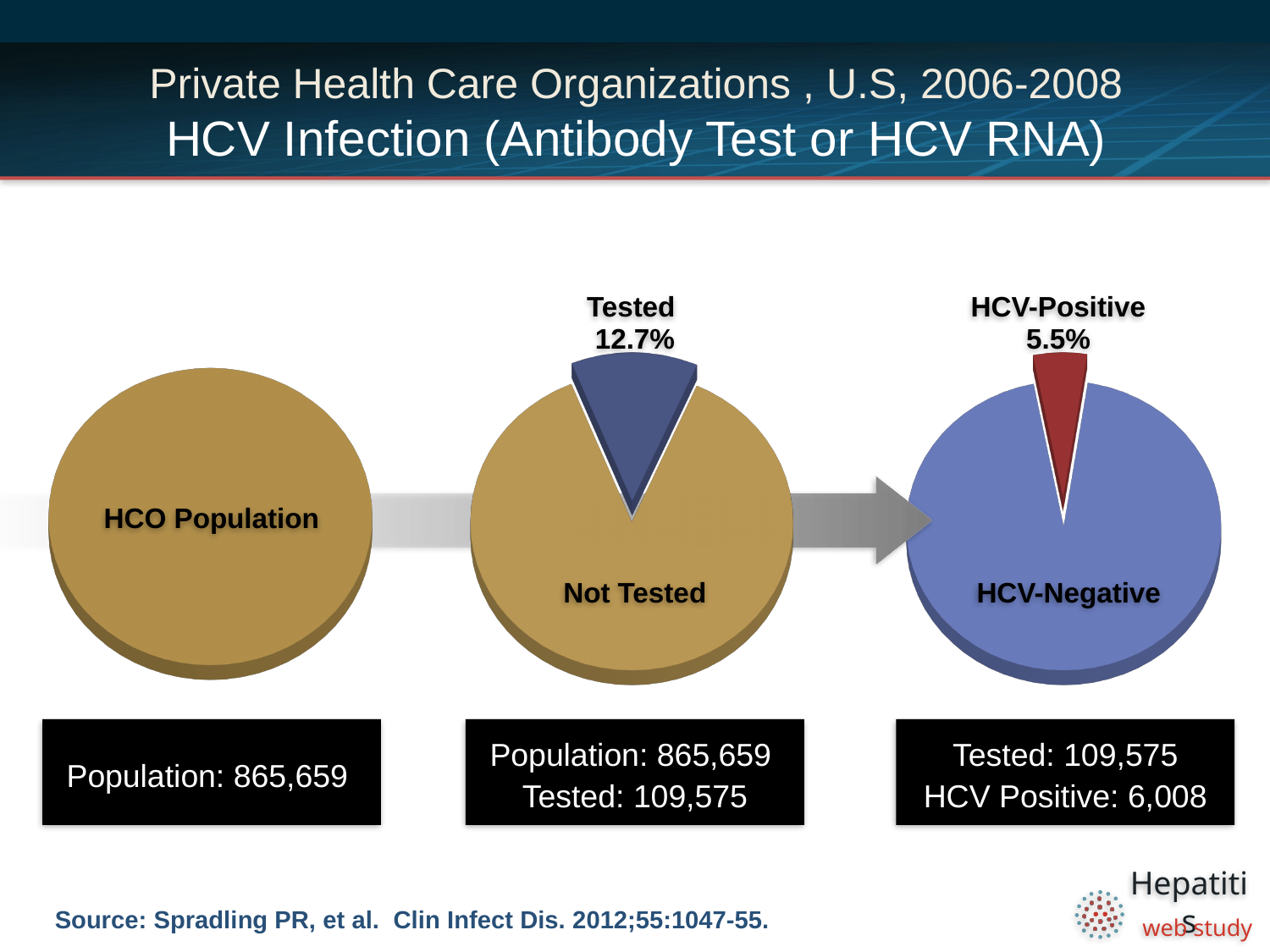
According to the box under the right pie chart, how many people were HCV Positive? 6,008 What is the label on the left pie chart? HCO Population According to the box under the middle pie chart, how many people were Tested? 109,575 According to the box under the left pie chart, what is the Population? 865,659 In the middle pie chart, what percentage of the population is labelled as Tested? 12.7% In the right pie chart, which slice is larger, HCV-Positive or HCV-Negative? HCV-Negative How many slices does the right pie chart have? 2 How many slices does the middle pie chart have? 2 In the middle pie chart, which slice is larger, Tested or Not Tested? Not Tested In the right pie chart, what percentage is labelled HCV-Positive? 5.5% What kind of chart is used on this slide? Pie chart How many pie charts are shown on the slide? 3